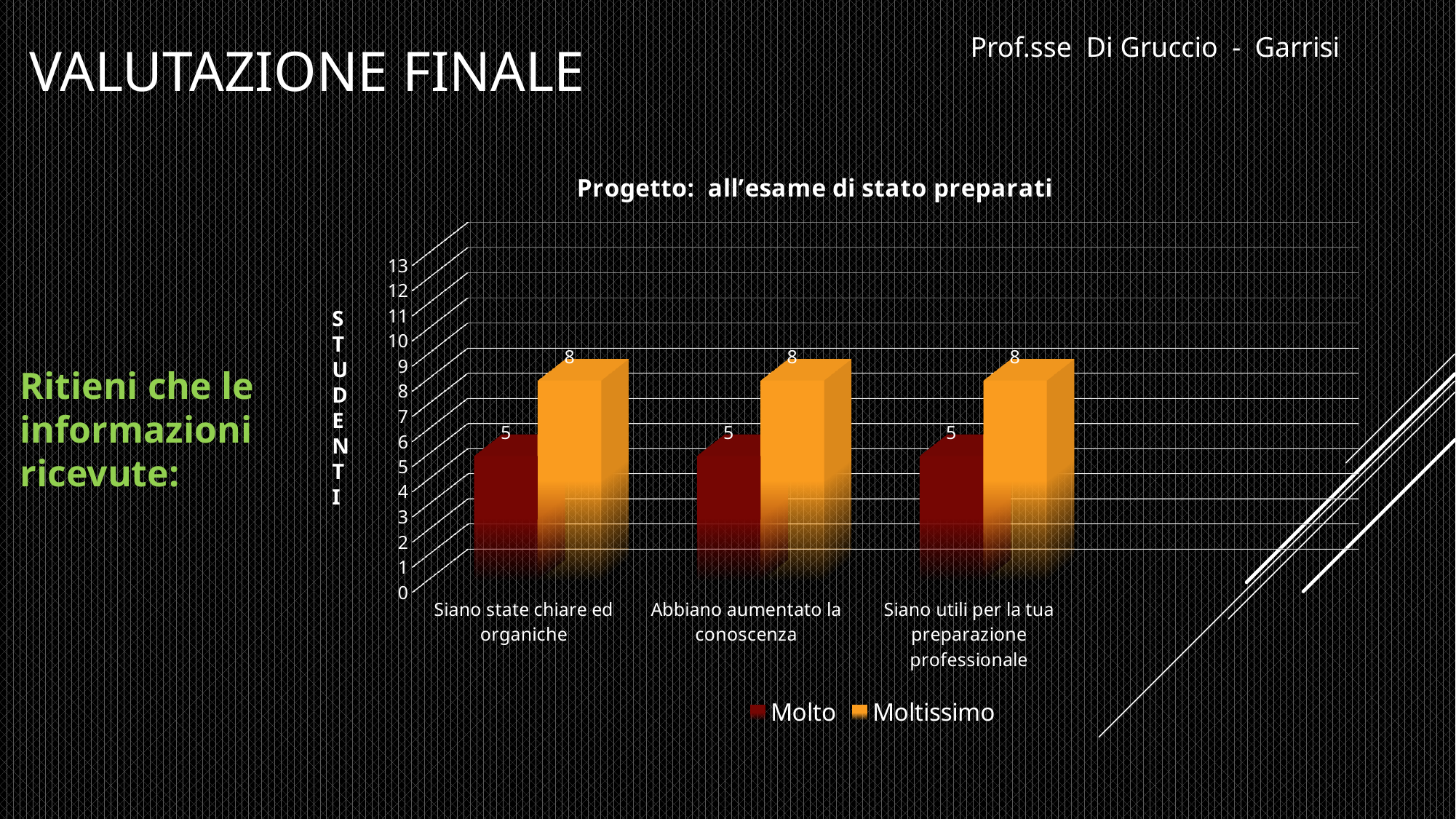
What is the value for "Molto" in the category "Siano state chiare ed organiche"? 5 Which colour represents the "Moltissimo" series in the legend? orange What is the total of the "Molto" and "Moltissimo" values for "Abbiano aumentato la conoscenza"? 13 What is the title of the chart? Progetto: all'esame di stato preparati How many categories are shown on the x axis? 3 What is the difference between the "Moltissimo" and "Molto" values for "Siano state chiare ed organiche"? 3 What is the value for "Molto" in the category "Siano utili per la tua preparazione professionale"? 5 What kind of chart is shown on the slide? bar chart How many series does the legend list? 2 What is the value for "Moltissimo" in the category "Abbiano aumentato la conoscenza"? 8 Which series has the larger value in the category "Siano utili per la tua preparazione professionale", "Molto" or "Moltissimo"? Moltissimo Is the value for "Moltissimo" in "Siano state chiare ed organiche" greater or less than 10? less